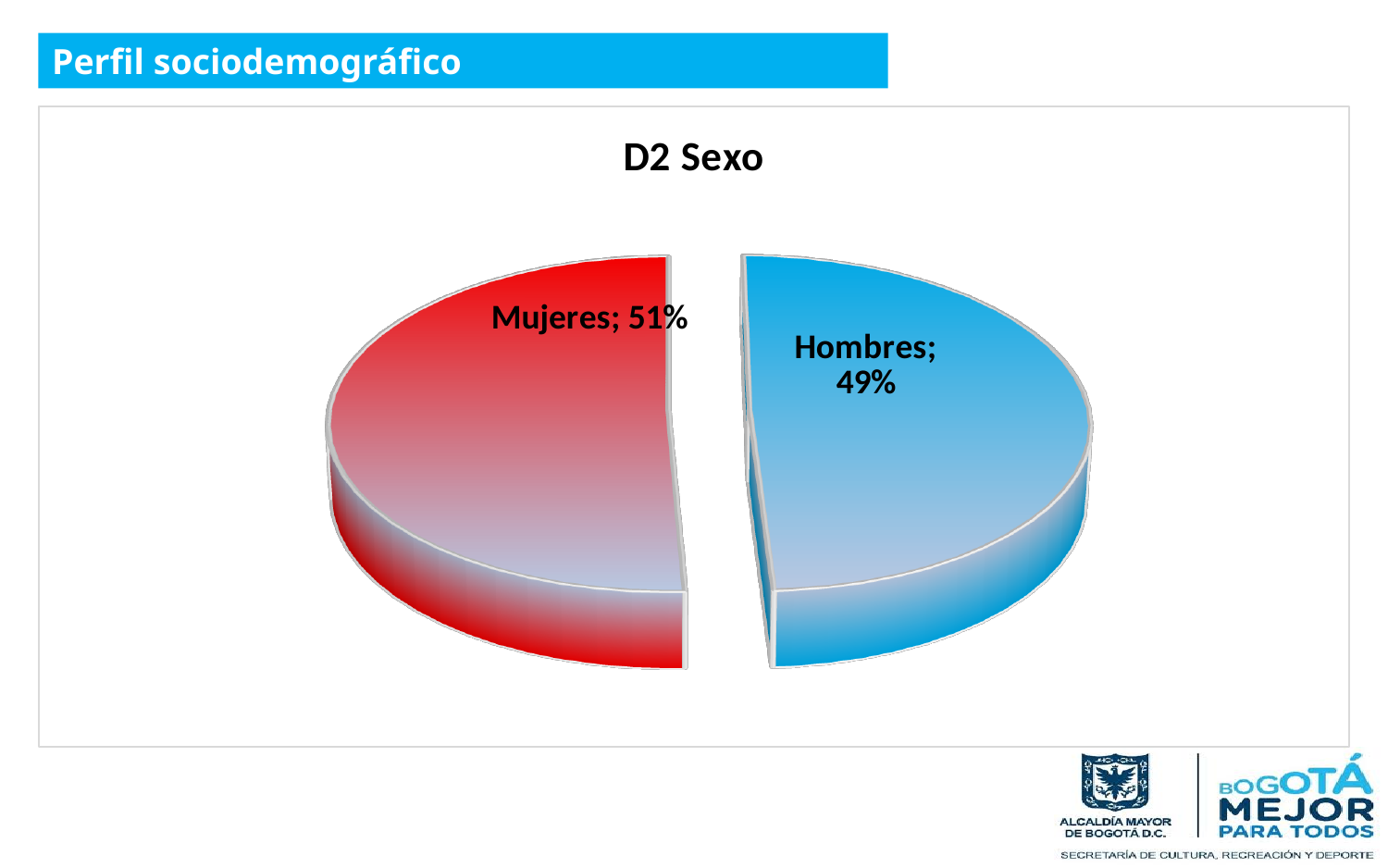
How many slices does the pie chart have? 2 Which is larger, the share for Mujeres or the share for Hombres? Mujeres What share of the pie is Mujeres? 51% What kind of chart is shown on the slide? Pie chart What is the difference in percentage points between Mujeres and Hombres? 2 What share of the pie is Hombres? 49% Which category has the largest slice? Mujeres What colour is the Hombres slice? Blue What is the title of the chart? D2 Sexo Which category has the smallest slice? Hombres